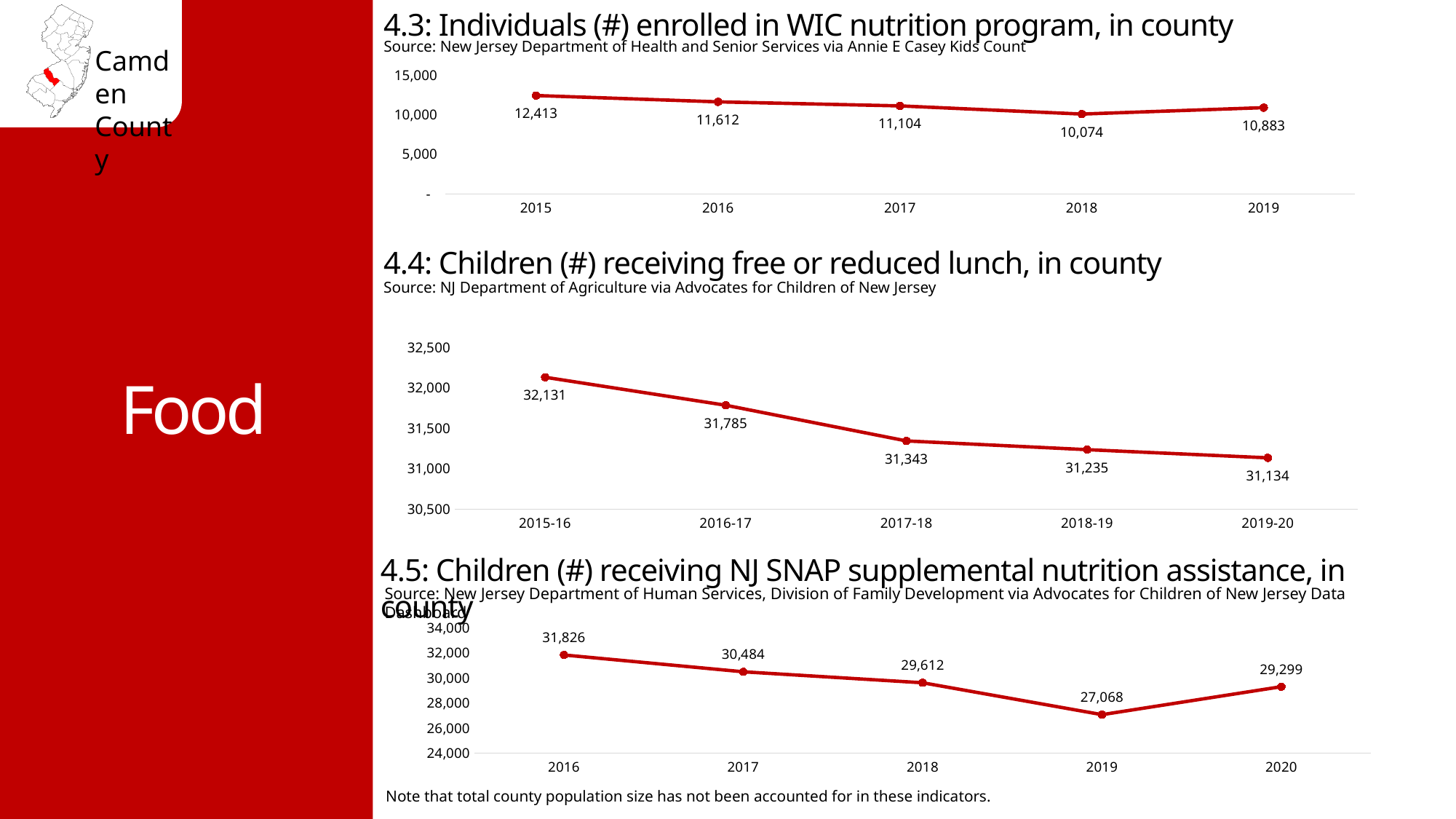
In the chart '4.4: Children (#) receiving free or reduced lunch, in county', which school year has the highest value? 2015-16 In the chart '4.3: Individuals (#) enrolled in WIC nutrition program, in county', which year has the lowest value? 2018 In the chart '4.3: Individuals (#) enrolled in WIC nutrition program, in county', how many data points are plotted? 5 In the chart '4.4: Children (#) receiving free or reduced lunch, in county', do the values rise or fall from 2015-16 to 2019-20? fall What is the source given for the chart '4.3: Individuals (#) enrolled in WIC nutrition program, in county'? New Jersey Department of Health and Senior Services via Annie E Casey Kids Count In the chart '4.4: Children (#) receiving free or reduced lunch, in county', what is the value for 2017-18? 31,343 In the chart '4.3: Individuals (#) enrolled in WIC nutrition program, in county', what is the value for 2015? 12,413 What kind of chart is '4.4: Children (#) receiving free or reduced lunch, in county'? line chart In the chart '4.5: Children (#) receiving NJ SNAP supplemental nutrition assistance, in county', which is larger, the value for 2018 or the value for 2020? 2018 In the chart '4.5: Children (#) receiving NJ SNAP supplemental nutrition assistance, in county', what is the value for 2019? 27,068 In the chart '4.5: Children (#) receiving NJ SNAP supplemental nutrition assistance, in county', what is the difference between the 2016 and 2017 values? 1,342 In the chart '4.3: Individuals (#) enrolled in WIC nutrition program, in county', what is the difference between the 2015 and 2019 values? 1,530